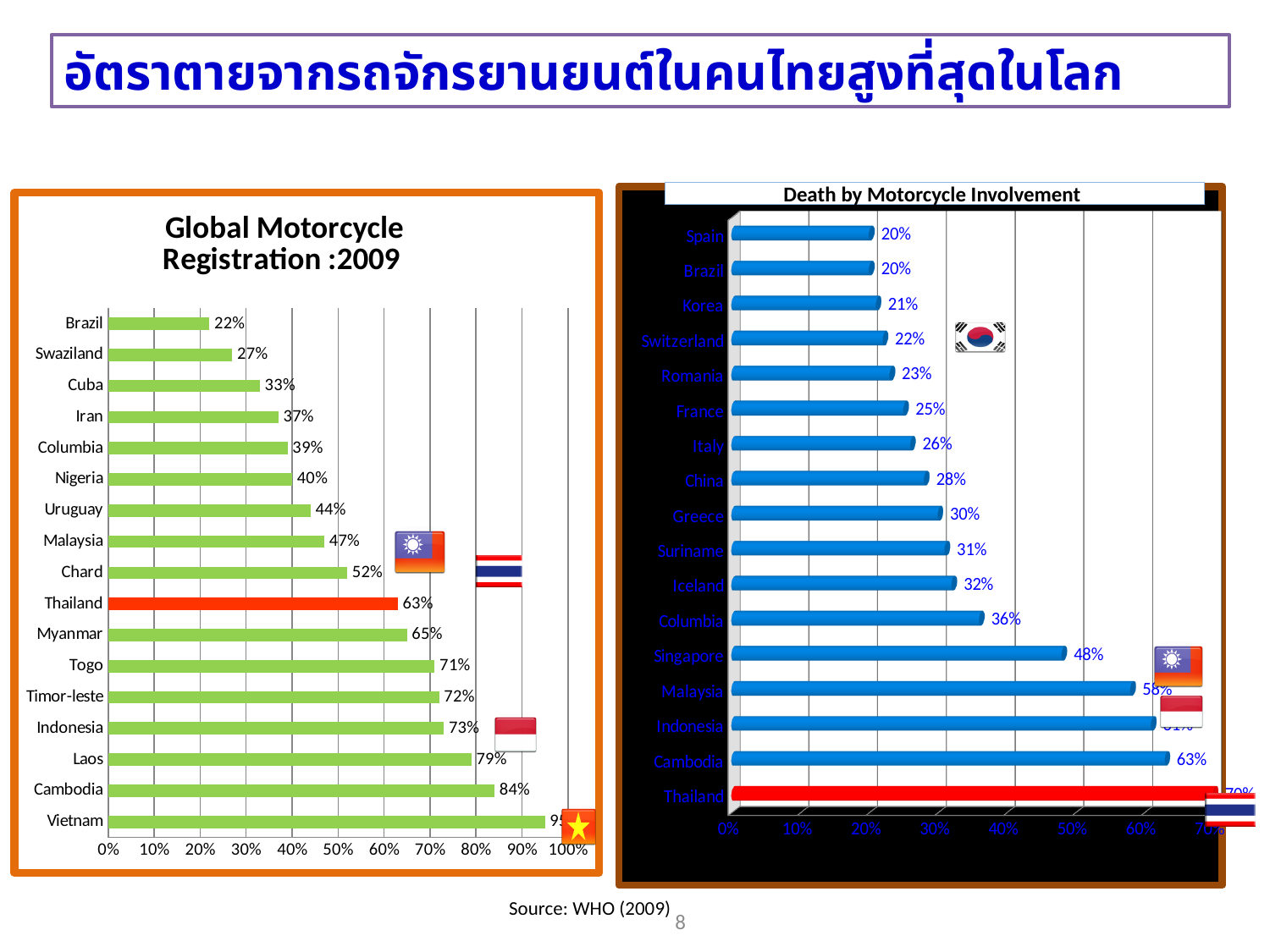
In the Death by Motorcycle Involvement chart, which country has the highest value? Thailand What type of chart is the Death by Motorcycle Involvement chart? bar chart In the Global Motorcycle Registration :2009 chart, how many countries are shown? 17 In the Death by Motorcycle Involvement chart, which is larger, Columbia or Iceland? Columbia In the Death by Motorcycle Involvement chart, is the value for Thailand greater or less than 60%? greater In the Global Motorcycle Registration :2009 chart, what is the value for Thailand? 63% In the Global Motorcycle Registration :2009 chart, which country has the highest value? Vietnam In the Death by Motorcycle Involvement chart, what is the value for Singapore? 48% In the Global Motorcycle Registration :2009 chart, what is the value for Cambodia? 84% In the Death by Motorcycle Involvement chart, what is the value for Greece? 30% In the Global Motorcycle Registration :2009 chart, which country has the lowest value? Brazil In the Global Motorcycle Registration :2009 chart, what is the difference between Laos and Indonesia? 6%